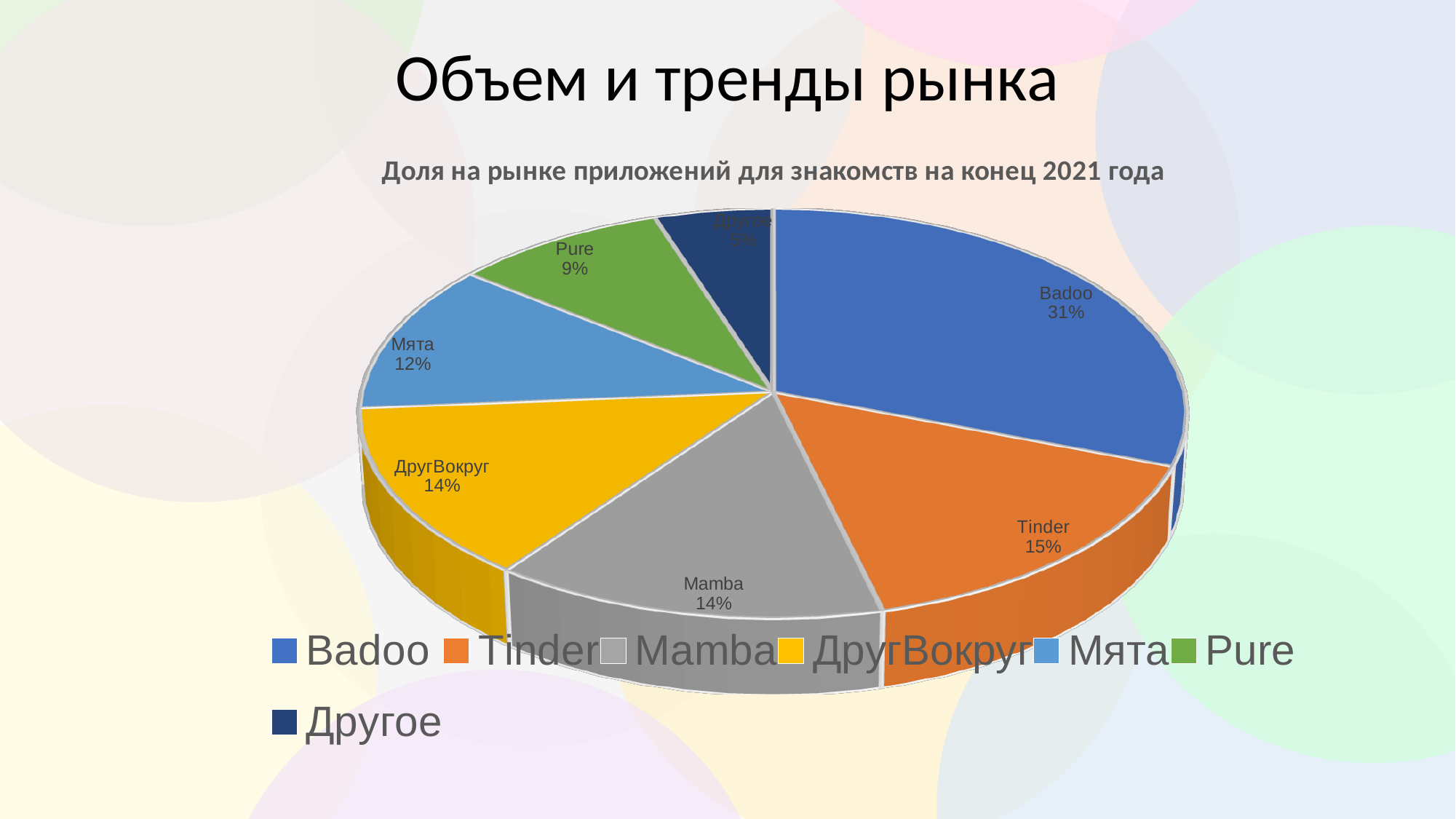
What is the difference between the shares of Badoo and Tinder? 16% What share of the market does Tinder have? 15% Which category has the smallest share of the market? Другое What colour is the Mamba slice? grey What is the title of the chart? Доля на рынке приложений для знакомств на конец 2021 года Which has a larger share, Мята or Pure? Мята What share of the market does Мята have? 12% What share of the market does Badoo have? 31% How many slices does the pie chart have? 7 What type of chart is shown on the slide? pie chart What share of the market does Pure have? 9% Which app has the largest share of the market? Badoo